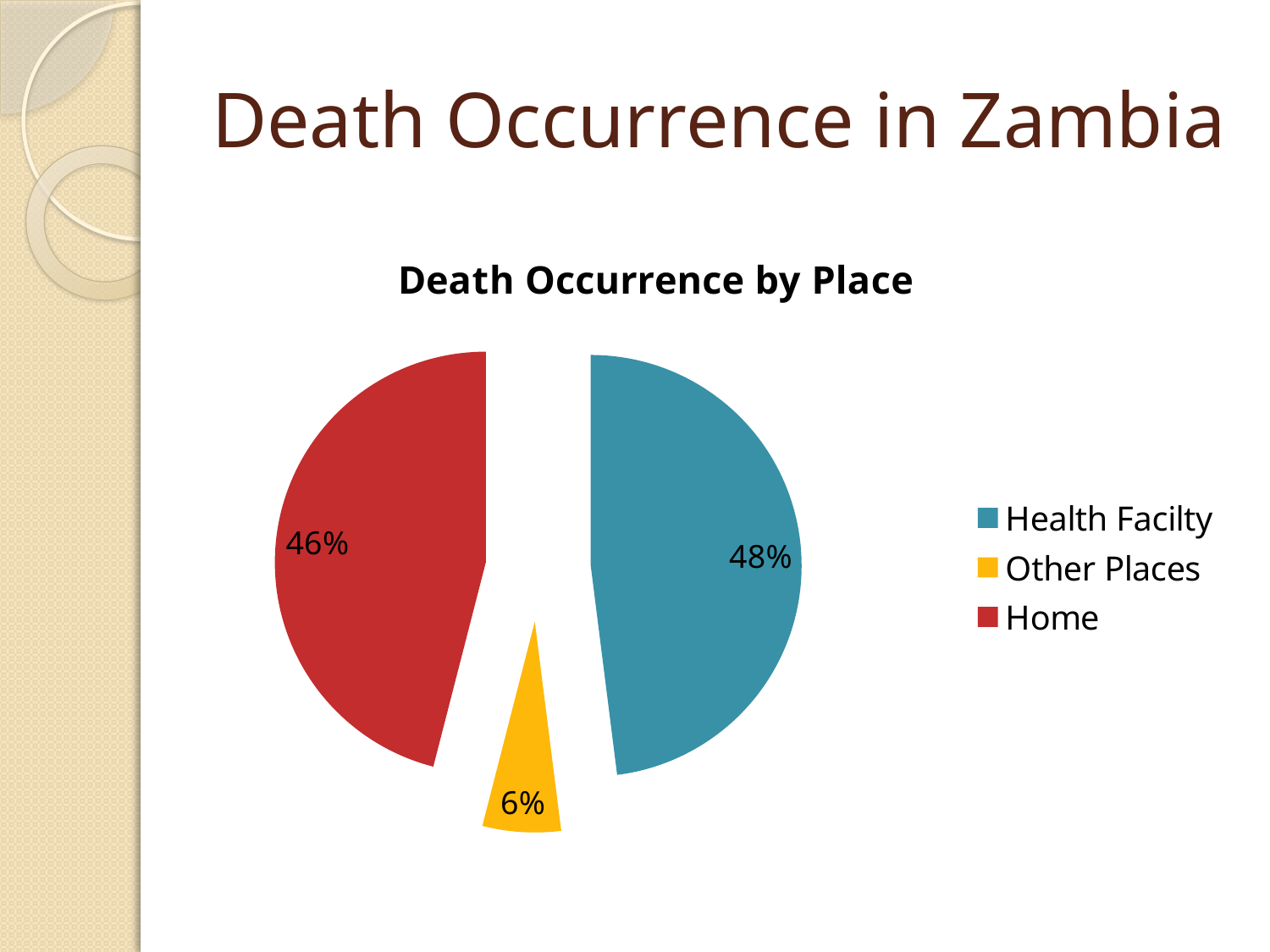
How many slices does the pie chart have? 3 What share of deaths occurred in Other Places? 6% What share of deaths occurred at Home? 46% What is the difference in percentage points between the Home and Other Places slices? 40 Which place accounts for the smallest share of deaths? Other Places What type of chart is shown on the slide? Pie chart Which place accounts for the largest share of deaths? Health Facilty Which colour represents Other Places in the pie chart? Yellow What is the difference in percentage points between the Health Facilty and Home slices? 2 What share of deaths occurred in a Health Facilty according to the pie chart? 48% What is the title of the chart? Death Occurrence by Place Which is larger, the share for Home or the share for Other Places? Home